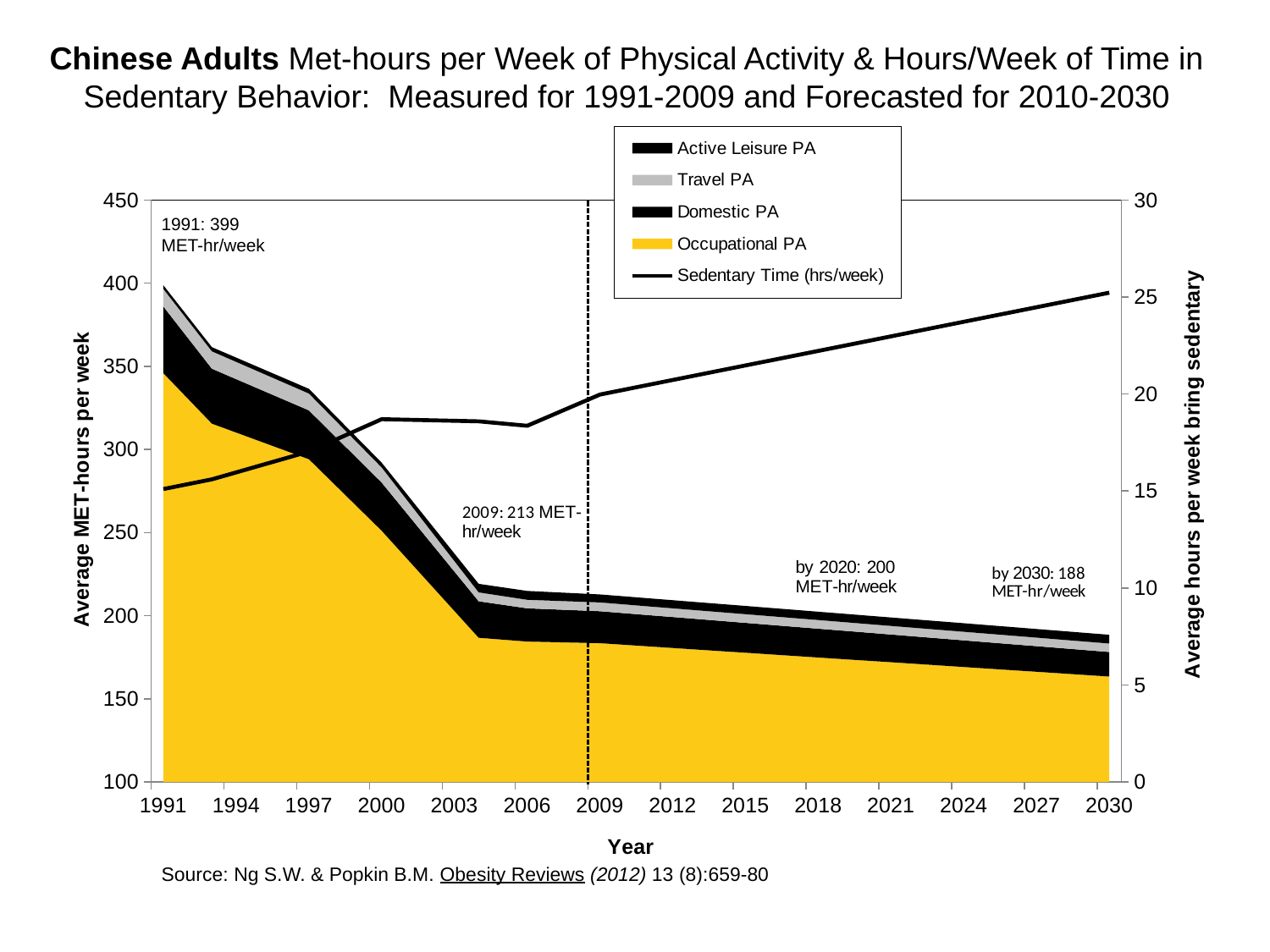
What total MET-hr/week is annotated for 2009? 213 MET-hr/week What is the difference between the annotated totals for 2020 and 2030? 12 MET-hr/week Is the Occupational PA value in 1991 greater or less than 300 MET-hours per week? greater What total MET-hr/week is forecast by 2020? 200 MET-hr/week What was the total physical activity in MET-hr/week for Chinese adults in 1991, according to the annotation? 399 MET-hr/week By how many MET-hr/week did the annotated total fall between 1991 and 2009? 186 What kind of chart is shown on the slide? Stacked area chart with a line Which legend series is shown in yellow? Occupational PA How many series does the legend list? 5 Does the Sedentary Time line rise or fall from 2009 to 2030? Rises Is the Sedentary Time value in 1991 greater or less than 20 hours per week? less What total MET-hr/week is forecast by 2030? 188 MET-hr/week